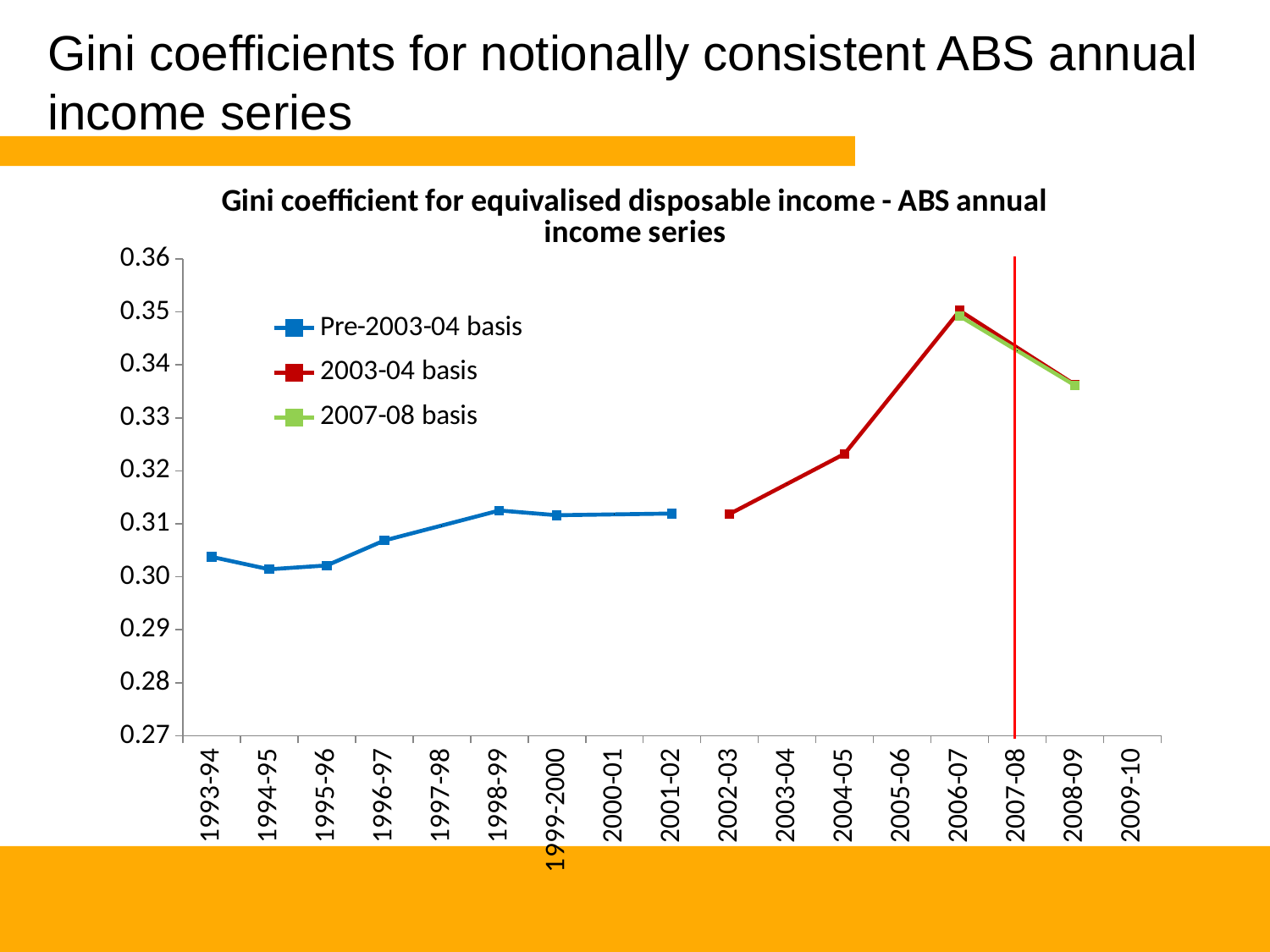
How many series does the legend list? 3 Which year has the highest value in the 2003-04 basis series? 2006-07 Does the 2007-08 basis series rise or fall from 2006-07 to 2008-09? fall Does the 2003-04 basis series rise or fall from 2002-03 to 2006-07? rise What kind of chart is shown on the slide? line chart Is the value for 2008-09 in the 2007-08 basis series greater or less than 0.33? greater What are the three series named in the legend? Pre-2003-04 basis, 2003-04 basis, 2007-08 basis Is the value for 2002-03 in the 2003-04 basis series greater or less than 0.32? less Is the value for 1994-95 in the Pre-2003-04 basis series greater or less than 0.31? less Which is larger: the 2004-05 value in the 2003-04 basis series or the 2001-02 value in the Pre-2003-04 basis series? 2004-05 (2003-04 basis)